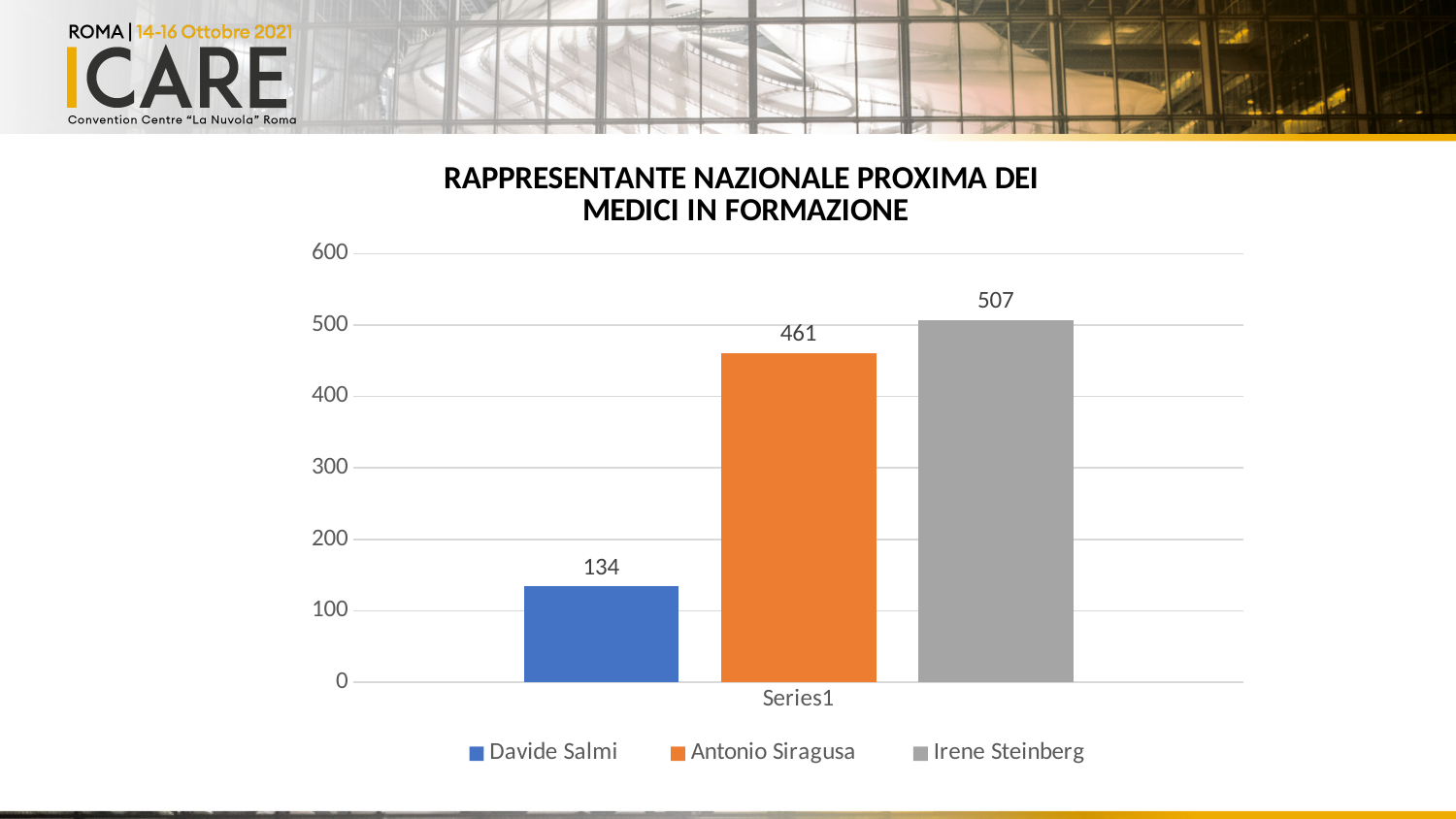
Is the value for Irene Steinberg greater or less than 500? greater What is the value for Irene Steinberg? 507 What is the title of the chart? RAPPRESENTANTE NAZIONALE PROXIMA DEI MEDICI IN FORMAZIONE Which candidate has the lowest value? Davide Salmi What is the difference between the values for Irene Steinberg and Antonio Siragusa? 46 What is the difference between the values for Antonio Siragusa and Davide Salmi? 327 What is the value for Antonio Siragusa? 461 What is the value for Davide Salmi? 134 What kind of chart is shown on the slide? bar chart How many series does the legend list? 3 Which is larger, the value for Antonio Siragusa or the value for Davide Salmi? Antonio Siragusa Which candidate has the highest value? Irene Steinberg